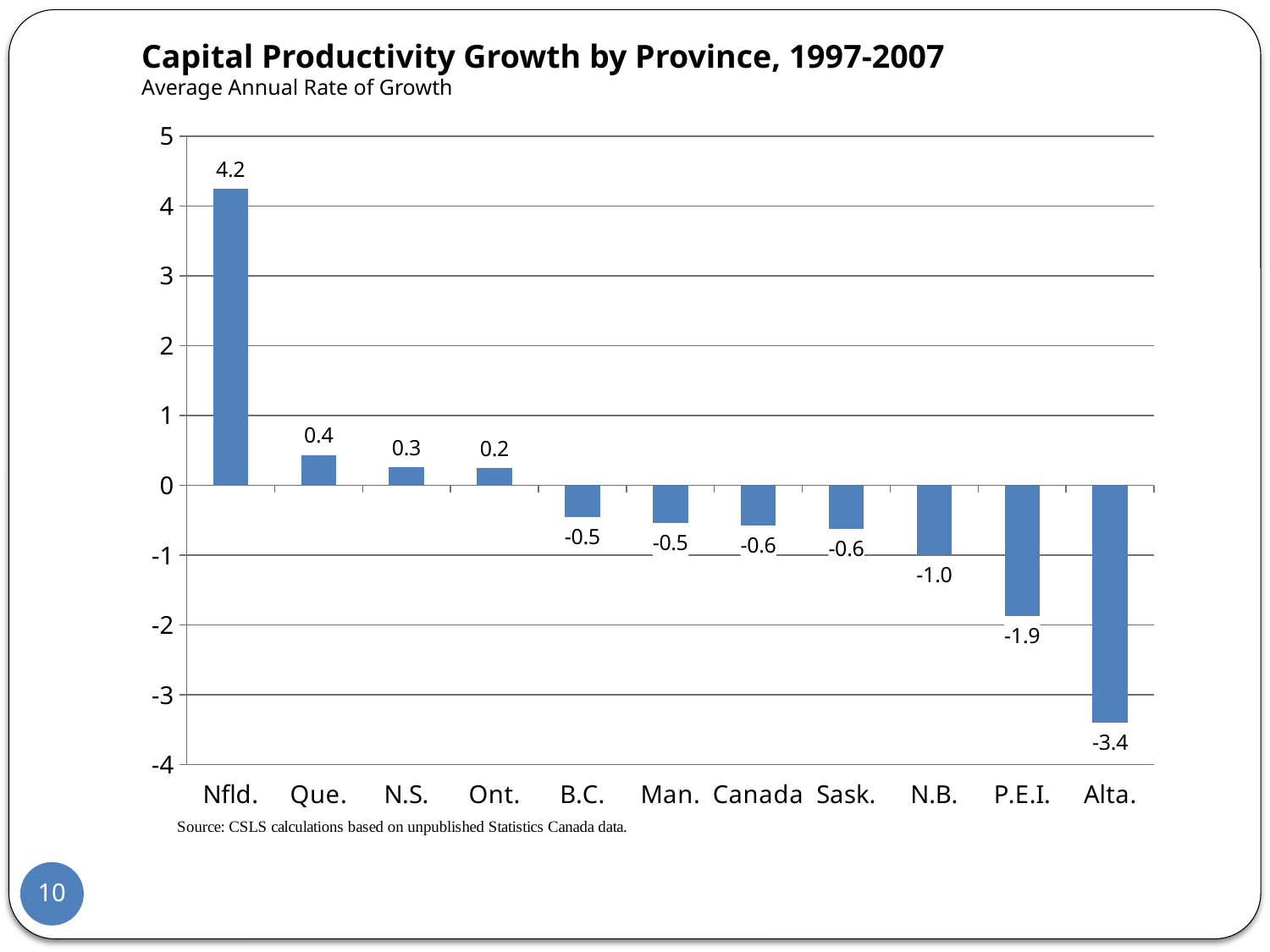
What is the difference between the values for P.E.I. and Alta.? 1.5 What is the difference between the values for Nfld. and Que.? 3.8 What is the value for Canada? -0.6 Which has a larger value, Ont. or N.B.? Ont. What is the title of the chart? Capital Productivity Growth by Province, 1997-2007 What is the value for P.E.I.? -1.9 What is the value for N.B.? -1.0 Which province has the lowest capital productivity growth? Alta. How many categories are shown on the x axis? 11 Which province has the highest capital productivity growth? Nfld. What is the value for Nfld.? 4.2 What kind of chart is this? Bar chart